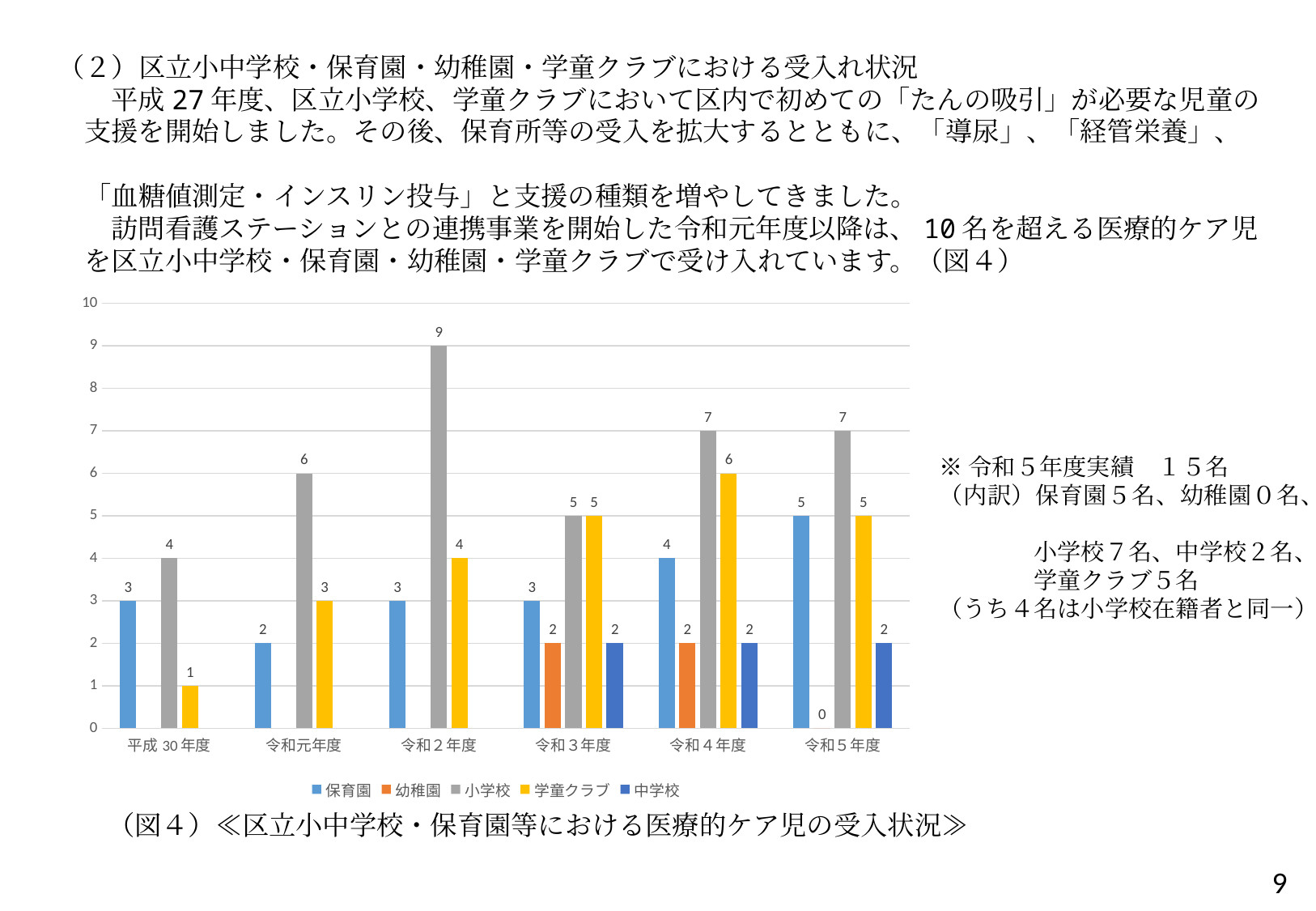
How many fiscal-year categories are shown on the x axis? 6 What is the value for 幼稚園 in 令和５年度? 0 In which fiscal year is the 保育園 value lowest? 令和元年度 What type of chart is shown on the slide? bar chart What is the difference between the 小学校 value and the 保育園 value in 令和２年度? 6 Which is larger in 令和４年度, the 保育園 value or the 学童クラブ value? 学童クラブ What is the value for 学童クラブ in 令和４年度? 6 How many series does the legend list? 5 What is the value for 小学校 in 令和２年度? 9 Does the 保育園 value rise or fall from 令和３年度 to 令和５年度? rise Which series is shown in grey in the chart? 小学校 In which fiscal year is the 小学校 value highest? 令和２年度